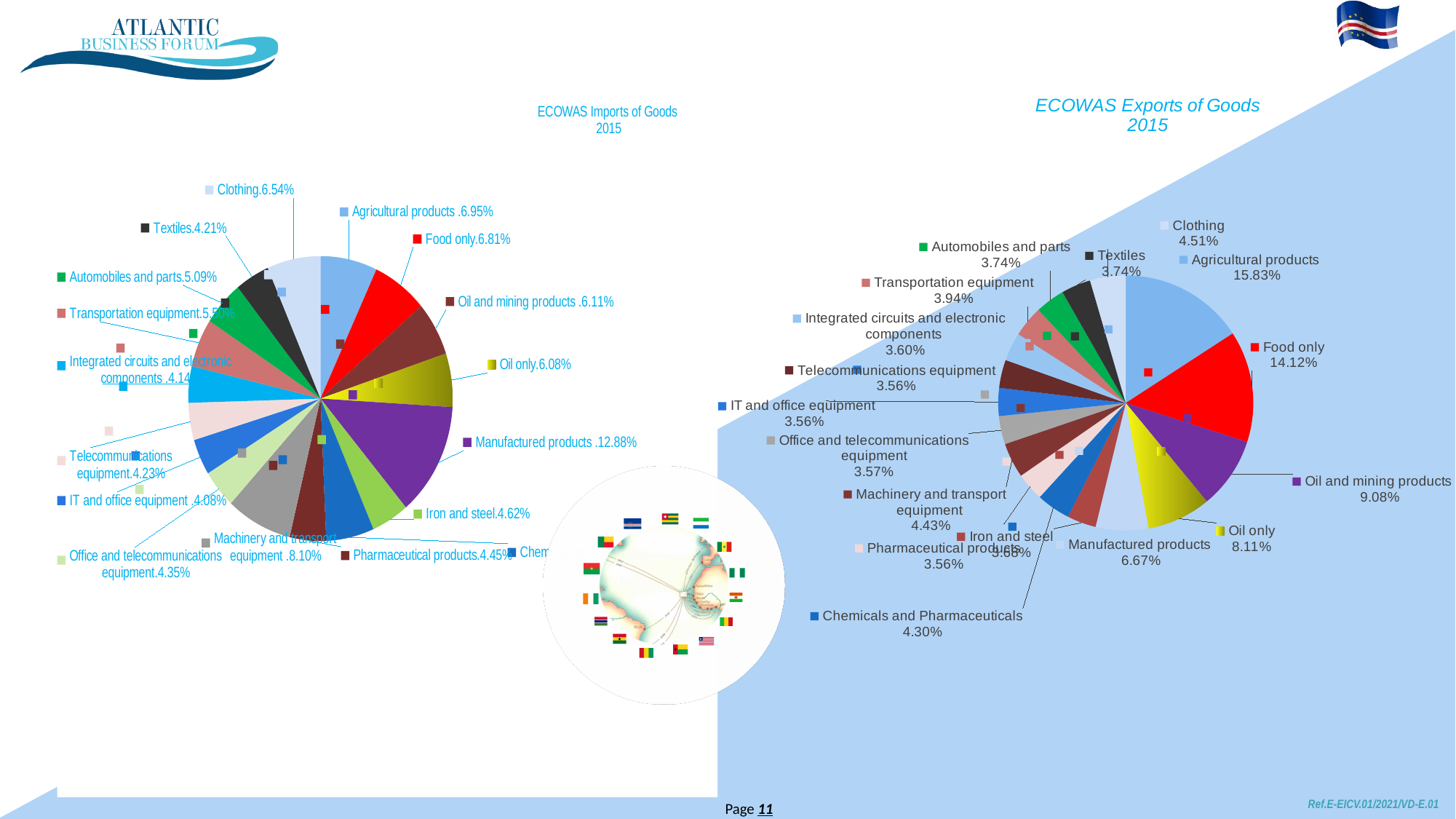
In the ECOWAS Exports of Goods 2015 chart, what is the share for Chemicals and Pharmaceuticals? 4.30% In the ECOWAS Imports of Goods 2015 chart, what share do Manufactured products have? 12.88% In the ECOWAS Imports of Goods 2015 chart, which category has the largest share? Manufactured products In the ECOWAS Exports of Goods 2015 chart, what share do Agricultural products have? 15.83% Is the share of Oil only larger in the ECOWAS Imports of Goods 2015 chart or the ECOWAS Exports of Goods 2015 chart? ECOWAS Exports of Goods 2015 In the ECOWAS Exports of Goods 2015 chart, what is the difference between the shares of Agricultural products and Food only? 1.71 percentage points How many categories are shown in the ECOWAS Exports of Goods 2015 pie chart? 17 In the ECOWAS Exports of Goods 2015 chart, which is larger: Oil and mining products or Oil only? Oil and mining products In the ECOWAS Imports of Goods 2015 chart, what is the share for Machinery and transport equipment? 8.10% In the ECOWAS Imports of Goods 2015 chart, what is the difference between the shares of Manufactured products and Machinery and transport equipment? 4.78 percentage points What type of chart is the ECOWAS Imports of Goods 2015 chart? Pie chart In the ECOWAS Exports of Goods 2015 chart, which category has the largest share? Agricultural products